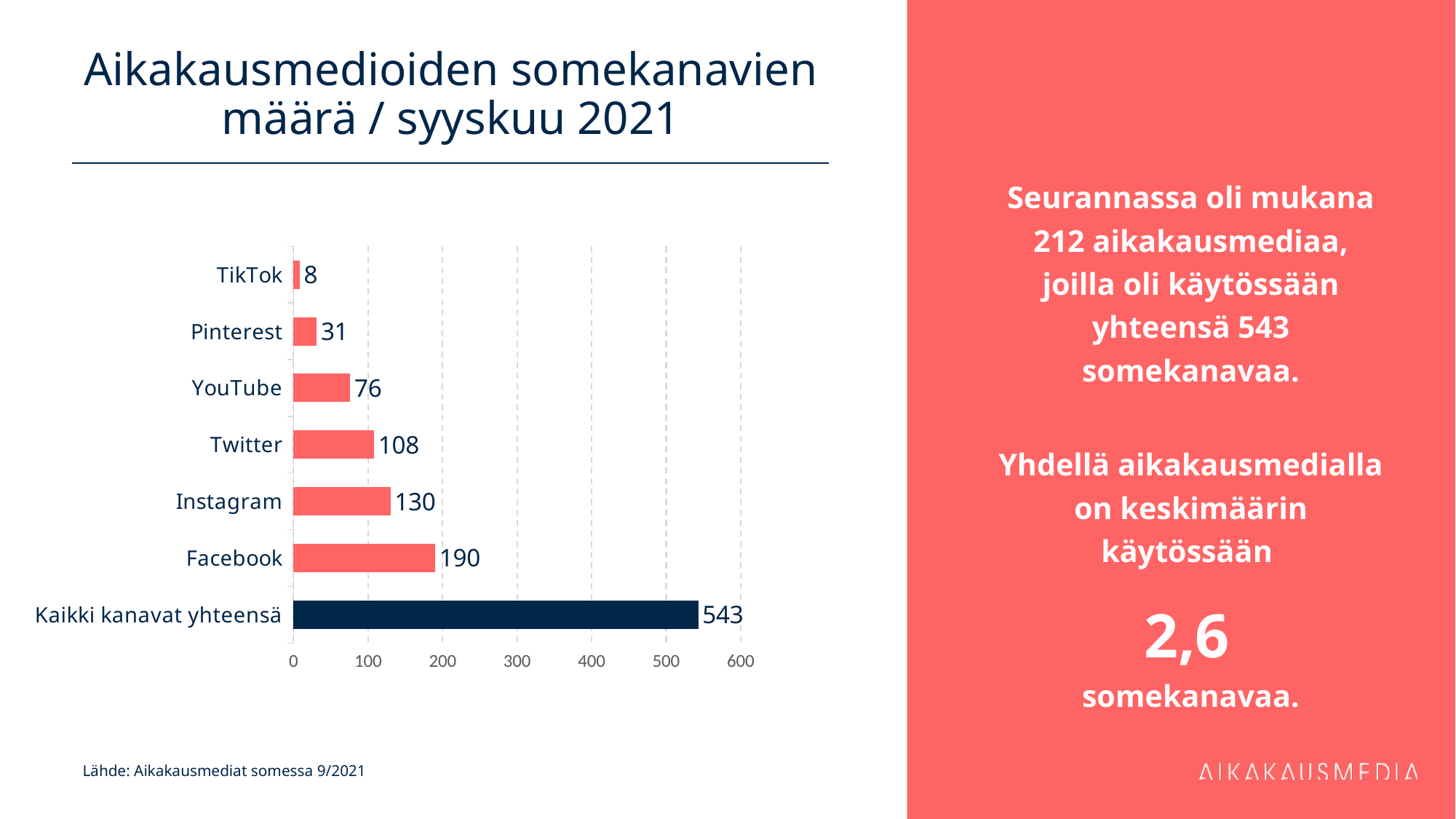
What is the value for Kaikki kanavat yhteensä? 543 Which is larger, the value for Twitter or the value for YouTube? Twitter How many categories are shown in the chart? 7 Is the value for Instagram greater or less than 100? greater Which category has the lowest value? TikTok What is the value for Facebook? 190 What is the difference between the values for Facebook and Instagram? 60 What is the value for TikTok? 8 What kind of chart is shown on the slide? bar chart What colour is the bar for Kaikki kanavat yhteensä? dark navy blue Which individual social media channel has the highest value? Facebook What is the difference between the values for Pinterest and TikTok? 23